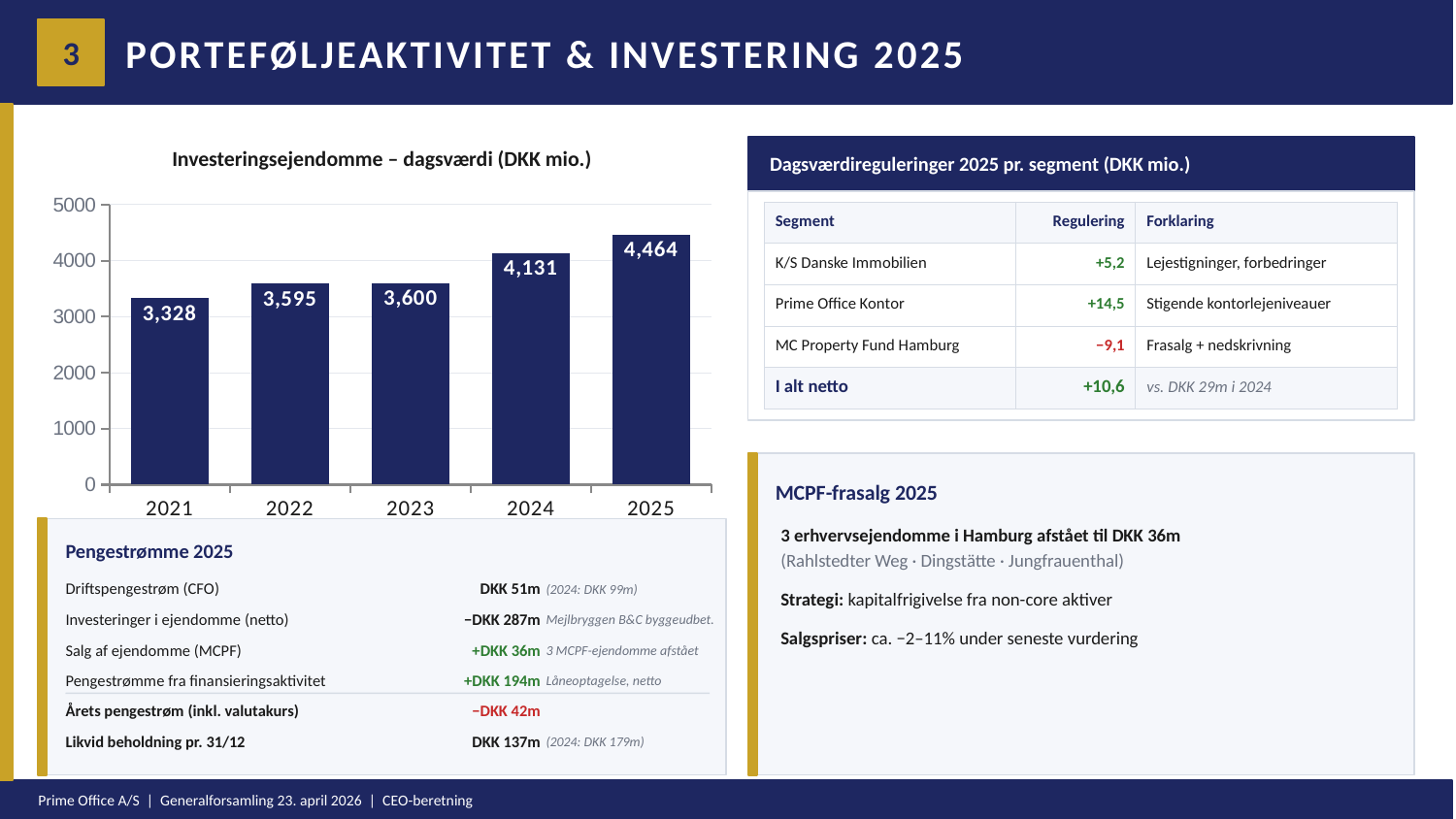
What is the value for 2023 in the chart? 3,600 What is the value for 2024 in the chart? 4,131 What type of chart is shown on the slide? bar chart What is the value for 2021 in the chart? 3,328 What is the difference between the values for 2025 and 2021? 1,136 What is the title of the chart? Investeringsejendomme – dagsværdi (DKK mio.) How many years are shown on the x axis of the chart? 5 Which is larger, the value for 2024 or the value for 2022? 2024 Do the values rise or fall from 2021 to 2025? rise Which year has the highest value in the chart? 2025 Which year has the lowest value in the chart? 2021 What is the difference between the values for 2025 and 2024? 333